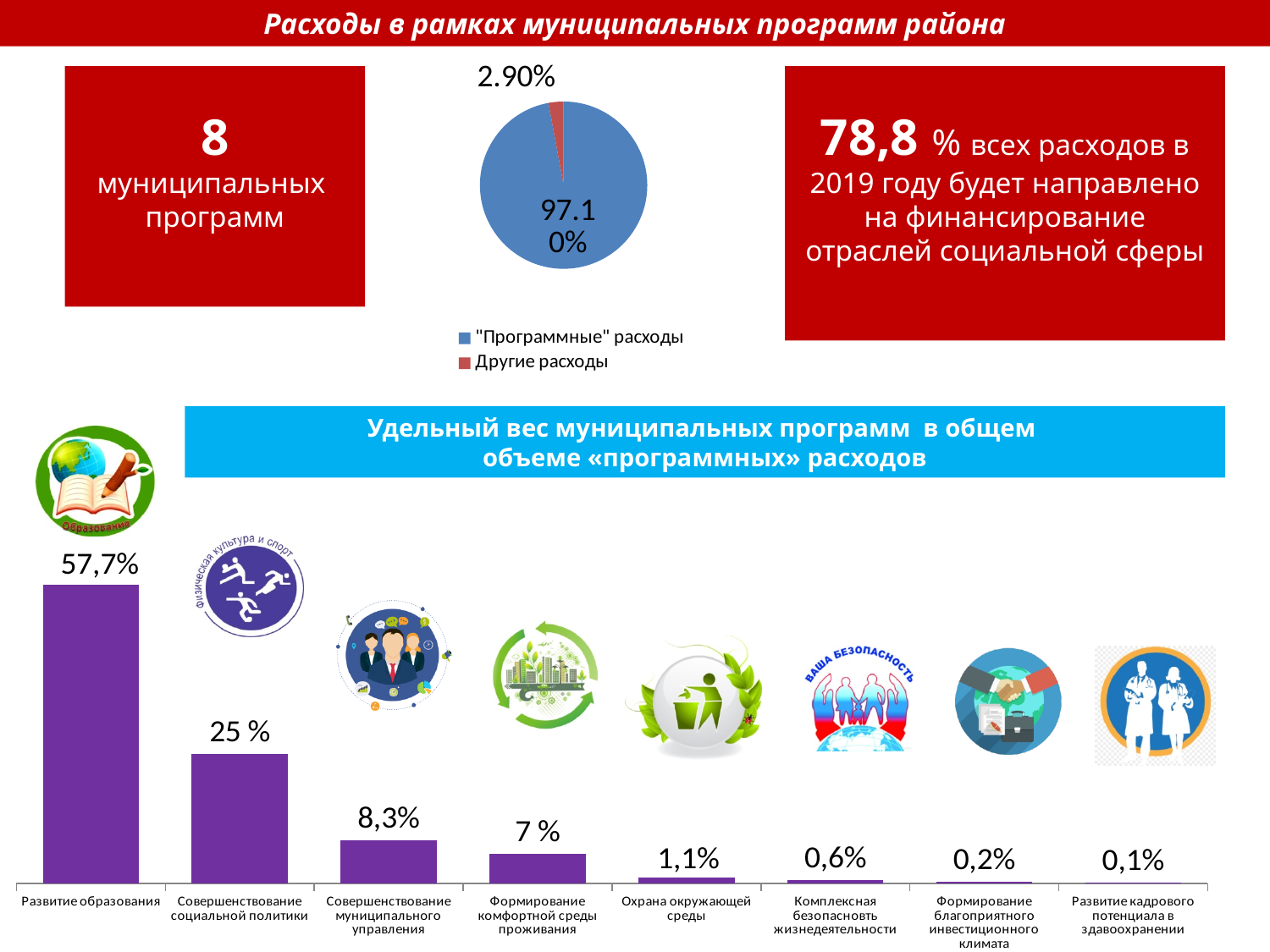
In the pie chart at the top of the slide, what share is labelled for "Другие расходы"? 2.90% In the bar chart "Удельный вес муниципальных программ в общем объеме «программных» расходов", which category has the highest value? Развитие образования How many entries does the legend of the pie chart at the top of the slide list? 2 What kind of chart is shown at the top centre of the slide? Pie chart In the bar chart "Удельный вес муниципальных программ в общем объеме «программных» расходов", do the values rise or fall from left to right? Fall In the bar chart "Удельный вес муниципальных программ в общем объеме «программных» расходов", what is the difference between Совершенствование муниципального управления and Формирование комфортной среды проживания? 1,3% In the bar chart "Удельный вес муниципальных программ в общем объеме «программных» расходов", how many categories are shown? 8 In the pie chart at the top of the slide, what share is labelled for "Программные" расходы? 97.10% In the bar chart "Удельный вес муниципальных программ в общем объеме «программных» расходов", which category has the lowest value? Развитие кадрового потенциала в здавоохранении In the bar chart "Удельный вес муниципальных программ в общем объеме «программных» расходов", what is the value for Совершенствование социальной политики? 25 % In the bar chart "Удельный вес муниципальных программ в общем объеме «программных» расходов", what is the value for Развитие образования? 57,7% In the bar chart "Удельный вес муниципальных программ в общем объеме «программных» расходов", what is the value for Охрана окружающей среды? 1,1%